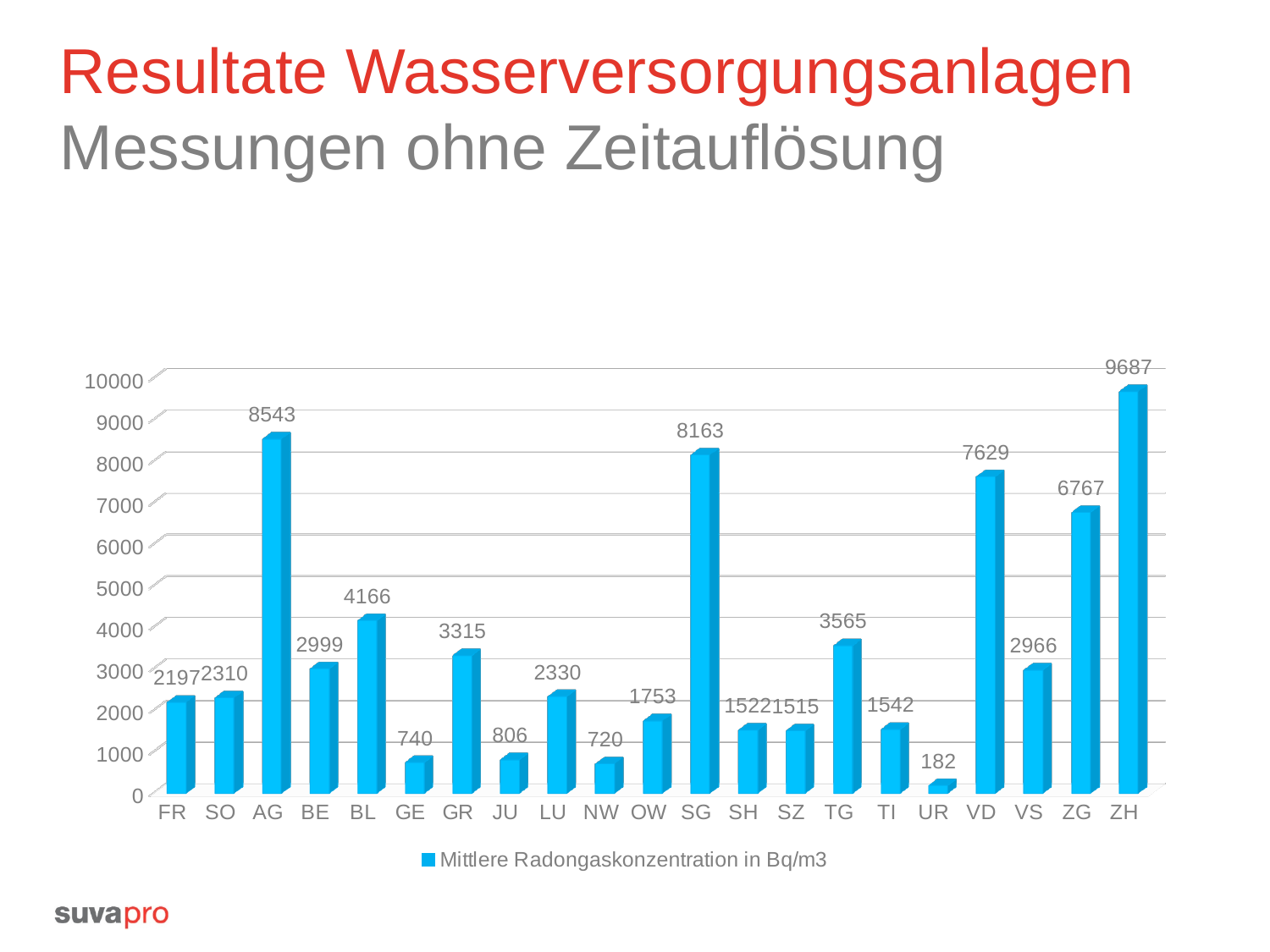
How many categories are shown on the x axis? 21 Is the value for GR greater or less than 3000? greater Which category has the highest value? ZH Which category has the lowest value? UR What is the difference between the values for VD and ZG? 862 What is the difference between the values for ZH and AG? 1144 Which is larger, the value for SG or the value for VD? SG What kind of chart is shown on the slide? bar chart How many series does the legend list? 1 What is the value for UR? 182 What is the value for TG? 3565 What is the value for AG? 8543